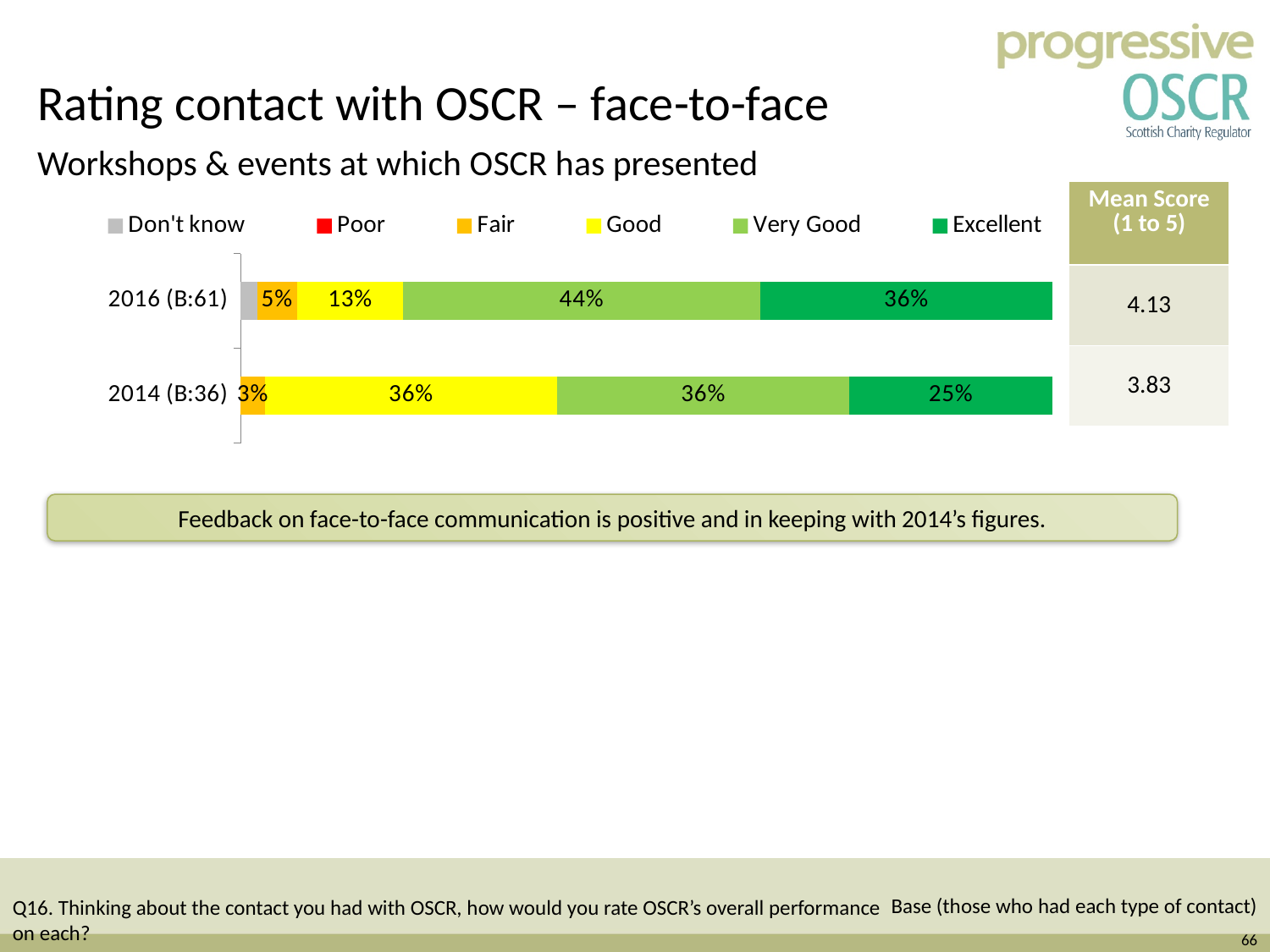
By how many percentage points does the Excellent share for 2016 exceed that for 2014? 11 percentage points What is the Fair value for 2016 (B:61)? 5% How many categories (years) are plotted on the chart? 2 What colour represents the Excellent series in the legend? Dark green What is the total of the labelled segments in the 2014 (B:36) bar? 100% Which rating has the largest share in the 2016 (B:61) bar? Very Good How many series does the chart legend list? 6 What percentage rated face-to-face contact as Excellent in 2014 (B:36)? 25% What percentage rated face-to-face contact as Very Good in 2016 (B:61)? 44% What kind of chart is shown on the slide? Stacked bar chart What is the Good value for 2014 (B:36)? 36% Which year has the larger Good share, 2016 or 2014? 2014